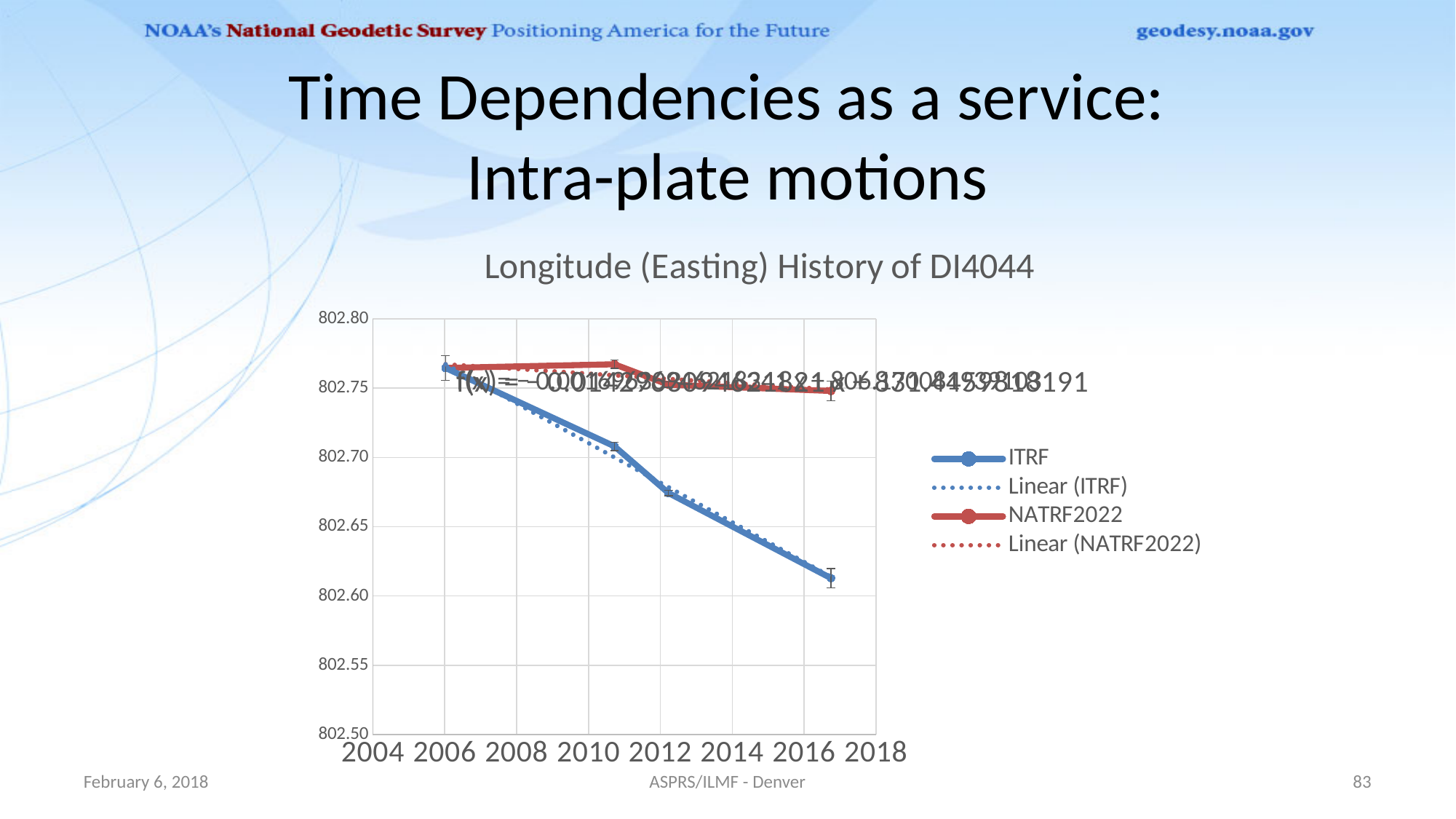
Is the NATRF2022 value at the last point (around 2017) greater or less than 802.70? greater Is the ITRF value at the last point (around 2017) greater or less than 802.65? less What is the title of the chart? Longitude (Easting) History of DI4044 Do the ITRF values rise or fall from 2006 to 2017? fall Is the ITRF value at the point around 2012 greater or less than 802.70? less Which series is drawn in red on the chart? NATRF2022 How many entries does the chart legend list? 4 What is the lowest value shown on the vertical axis? 802.50 Which series shows the larger decrease over the period, ITRF or NATRF2022? ITRF At the last point (around 2017), which series has the higher value, ITRF or NATRF2022? NATRF2022 What kind of chart is shown on the slide? line chart